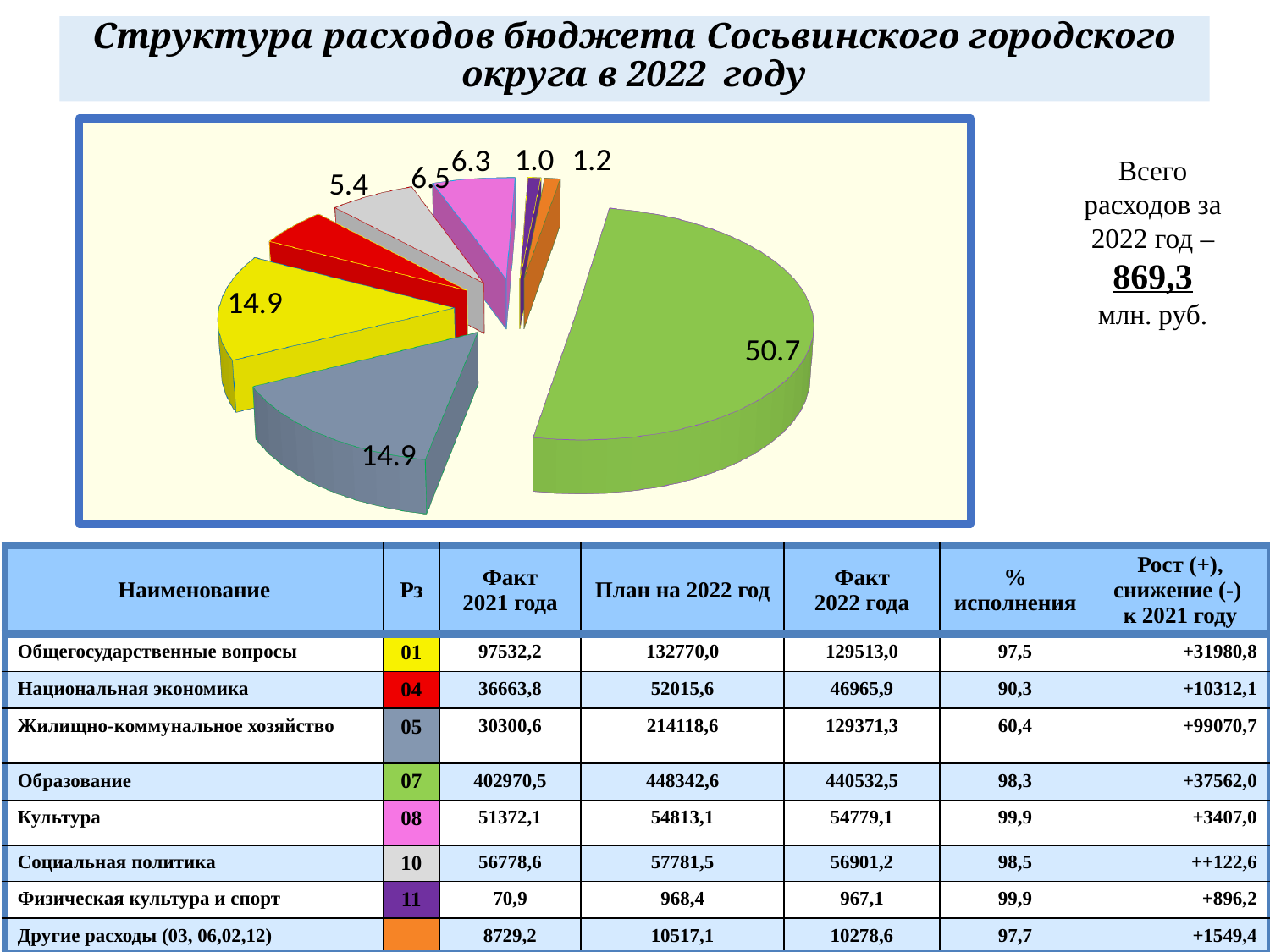
Which slice of the pie chart has the largest value? the green slice (50.7) What is the difference between the green slice (50.7) and the yellow slice (14.9) in the pie chart? 35.8 Which slice of the pie chart has the smallest value? the purple slice (1.0) What value is labelled on the red slice of the pie chart? 5.4 What value is labelled on the purple slice of the pie chart? 1.0 What value is labelled on the large green slice of the pie chart? 50.7 What is the title of the slide containing the pie chart? Структура расходов бюджета Сосьвинского городского округа в 2022 году Which is larger in the pie chart, the light grey slice (6.5) or the red slice (5.4)? the light grey slice (6.5) What value is labelled on the pink slice of the pie chart? 6.3 According to the text beside the pie chart, what is the total expenditure for 2022? 869,3 млн. руб. How many slices does the pie chart have? 8 What kind of chart is shown on the slide? pie chart